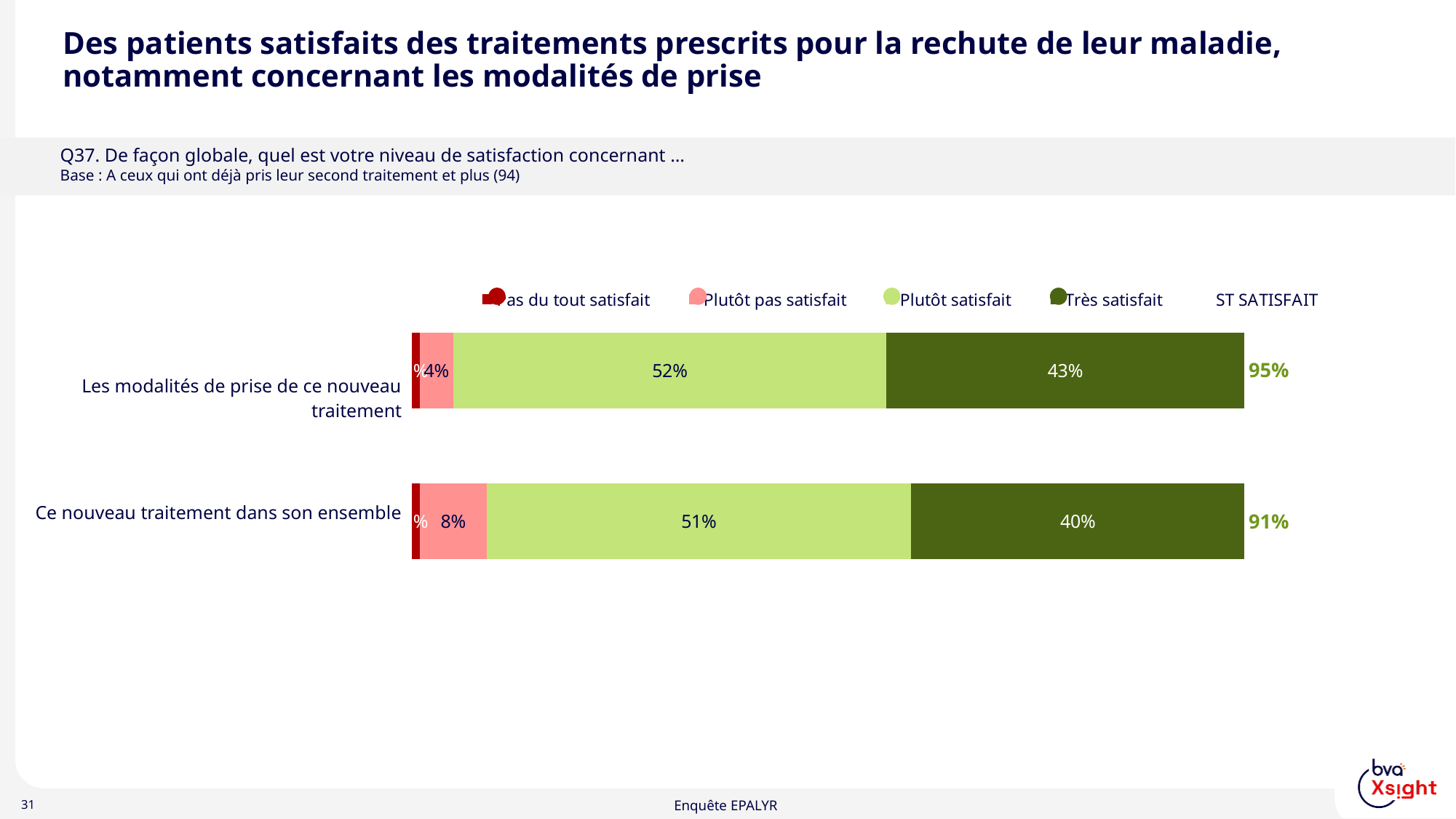
Which item has the higher 'ST SATISFAIT' value? Les modalités de prise de ce nouveau traitement Which item has the lower 'Très satisfait' percentage? Ce nouveau traitement dans son ensemble Which legend entry is shown in dark green? Très satisfait What is the difference between the two 'ST SATISFAIT' values? 4 percentage points What is the difference in 'Très satisfait' percentage between 'Les modalités de prise de ce nouveau traitement' and 'Ce nouveau traitement dans son ensemble'? 3 percentage points What percentage of respondents are 'Plutôt pas satisfait' with 'Ce nouveau traitement dans son ensemble'? 8% What is the 'ST SATISFAIT' value for 'Les modalités de prise de ce nouveau traitement'? 95% What percentage of respondents are 'Plutôt satisfait' with 'Les modalités de prise de ce nouveau traitement'? 52% What type of chart is shown on the slide? Stacked bar chart What percentage of respondents are 'Très satisfait' with 'Ce nouveau traitement dans son ensemble'? 40% How many items (categories) are shown in the chart? 2 Is the 'Plutôt pas satisfait' share larger for 'Les modalités de prise de ce nouveau traitement' or for 'Ce nouveau traitement dans son ensemble'? Ce nouveau traitement dans son ensemble